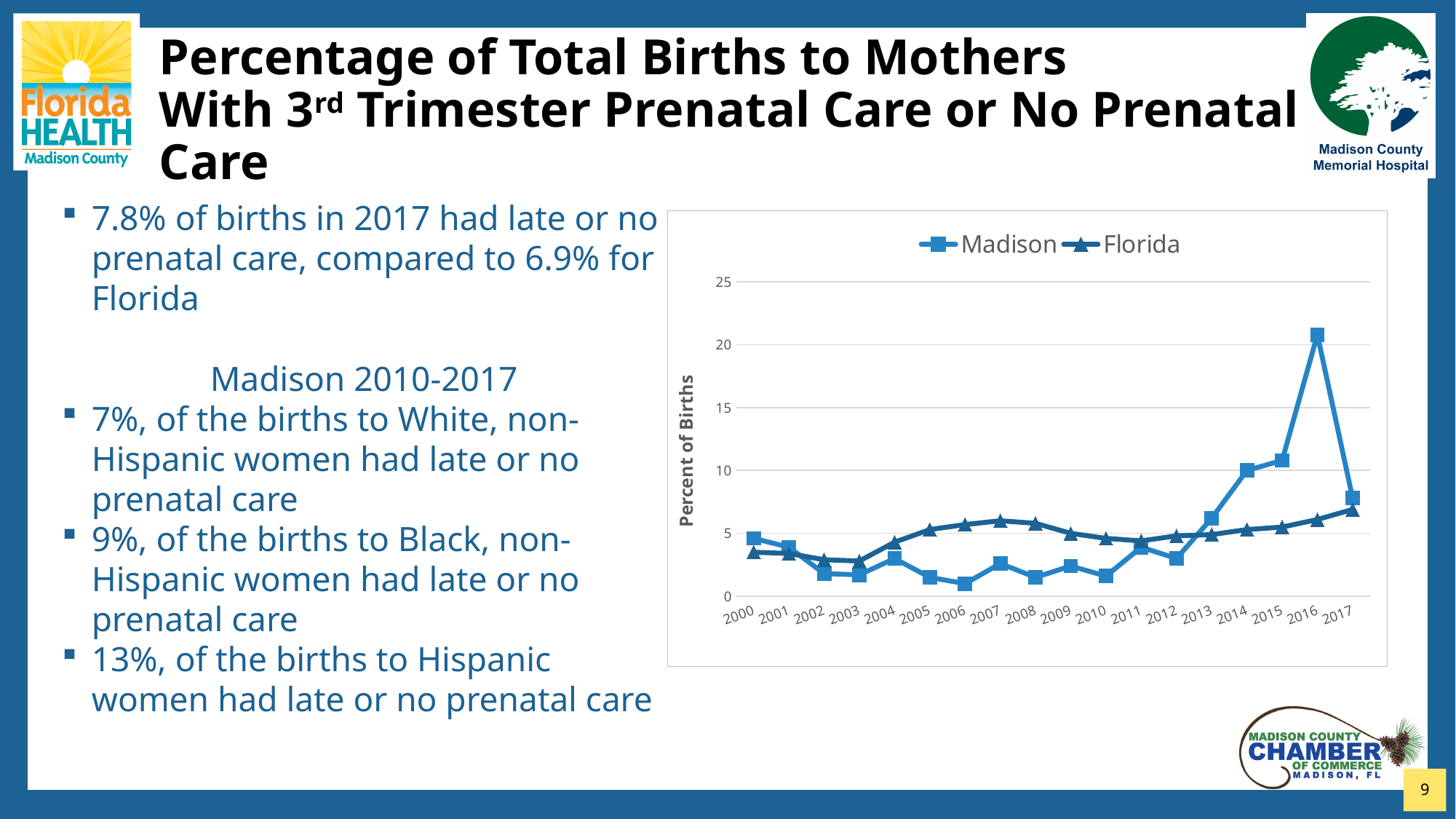
What is the title of the vertical axis of the chart? Percent of Births In 2010, which series has the larger value, Madison or Florida? Florida Does the Madison series rise or fall from 2012 to 2016? rise What kind of chart is shown on the slide? line chart Is the Florida value for 2007 greater or less than 5? greater How many series does the chart legend list? 2 Which two series are listed in the chart legend? Madison and Florida Is the Madison value for 2006 greater or less than 5? less Is the Madison value for 2016 greater or less than 20? greater In which year does the Madison series reach its highest value? 2016 How many years are plotted along the x axis of the chart? 18 In which year is the Madison series at its lowest value? 2006